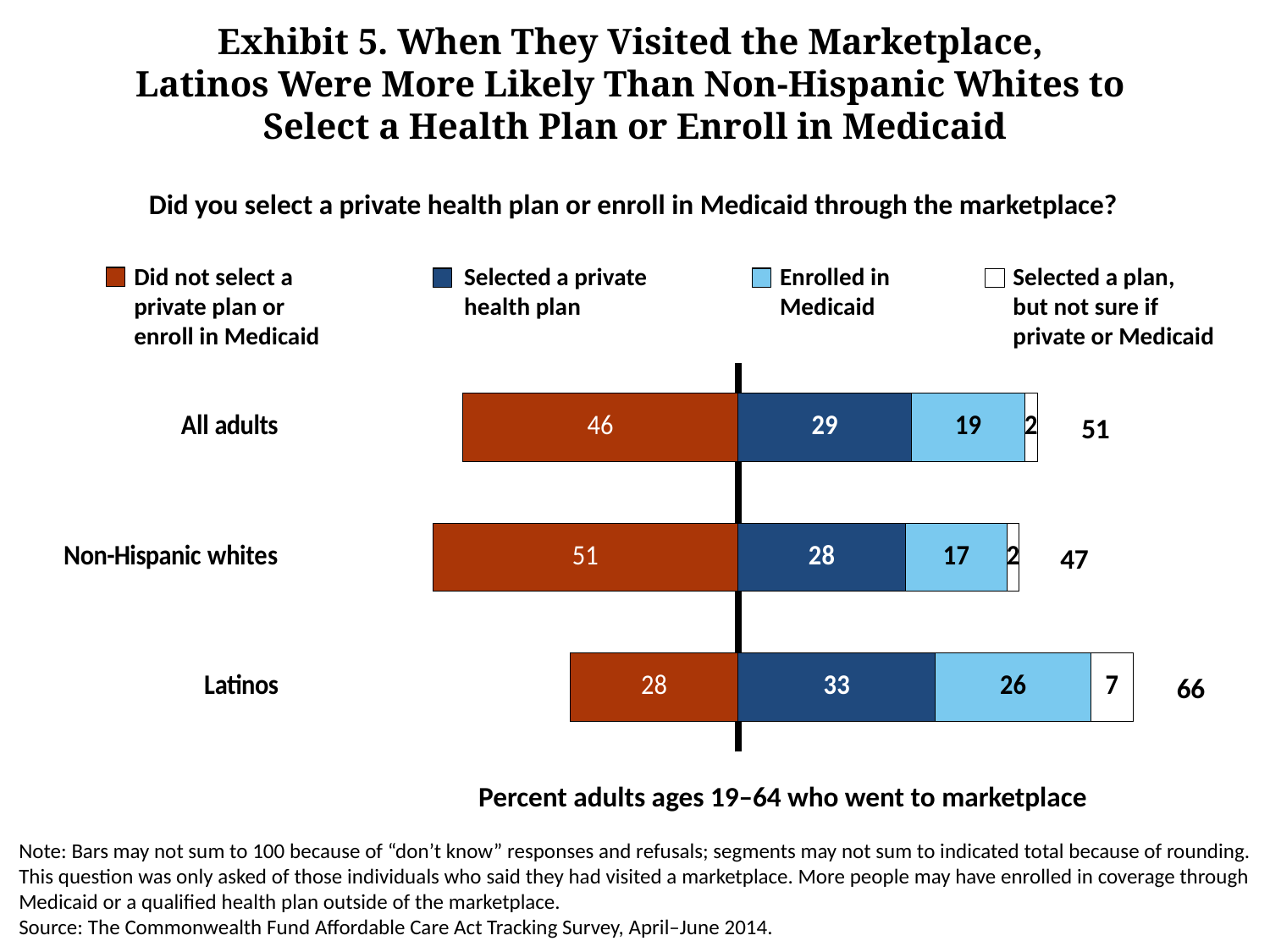
What percentage of all adults enrolled in Medicaid? 19 What percentage of Latinos selected a private health plan? 33 What kind of chart is shown on the slide? Stacked bar chart How many series does the legend list? 4 Which group has the highest percentage that enrolled in Medicaid? Latinos What total is printed to the right of the Latinos bar? 66 What percentage of Non-Hispanic whites did not select a private plan or enroll in Medicaid? 51 How many groups are shown in the chart? 3 What is the difference between the percentage of Latinos and Non-Hispanic whites who enrolled in Medicaid? 9 Who has a larger share that selected a private health plan, Latinos or Non-Hispanic whites? Latinos Which legend entry is shown in white? Selected a plan, but not sure if private or Medicaid Which group has the lowest percentage that did not select a private plan or enroll in Medicaid? Latinos